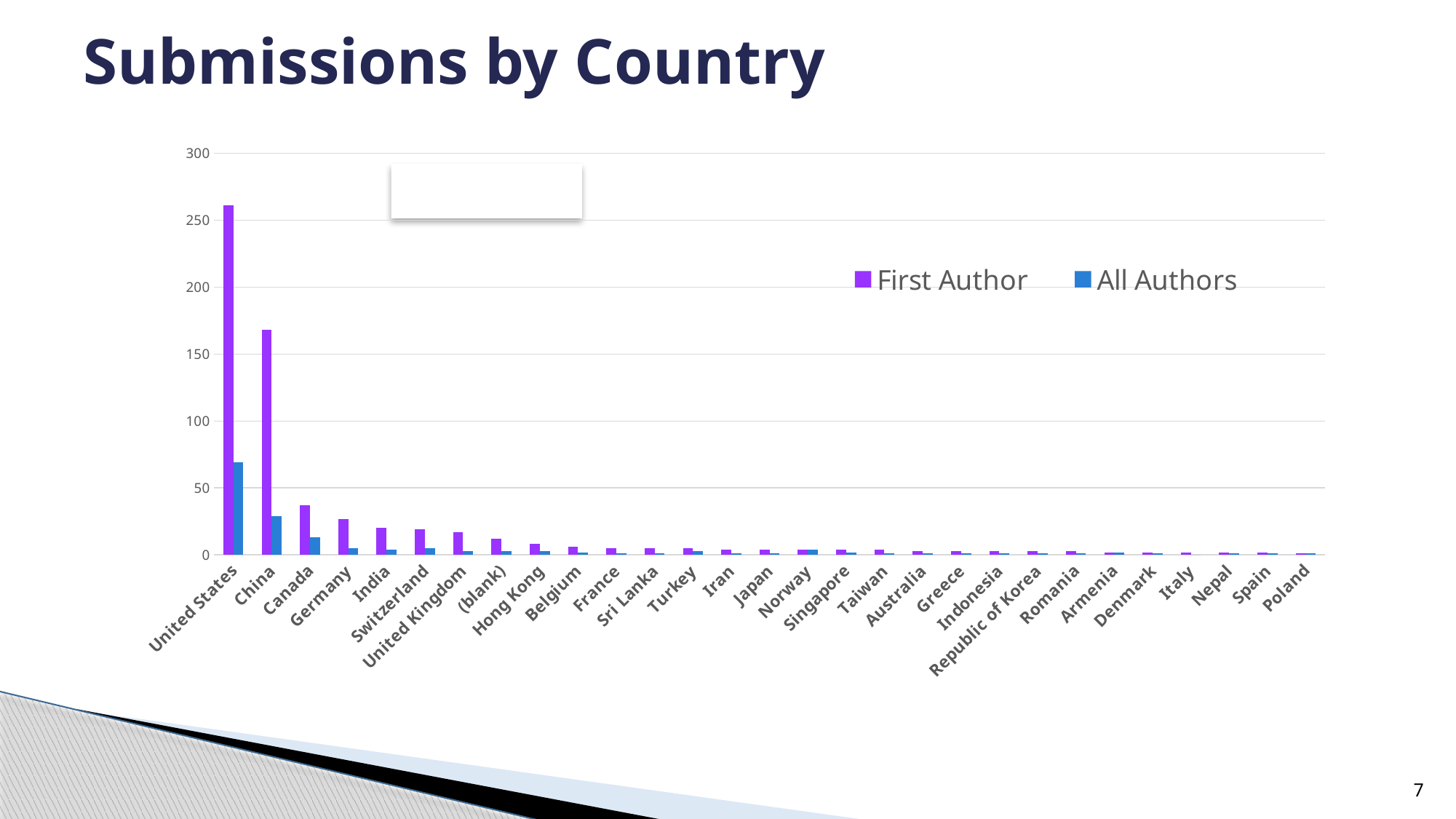
Is the All Authors value for United States greater or less than 50? greater How many series does the legend list? 2 What are the two series named in the legend? First Author and All Authors Which has the larger First Author value, China or Canada? China What type of chart is shown on the slide? bar chart Do the First Author values generally rise or fall moving from left to right along the x axis? fall Is the First Author value for Canada greater or less than 50? less Is the First Author value for China greater or less than 150? greater How many countries (categories) are shown on the x axis? 29 Which country has the highest First Author value? United States Which country has the highest All Authors value? United States